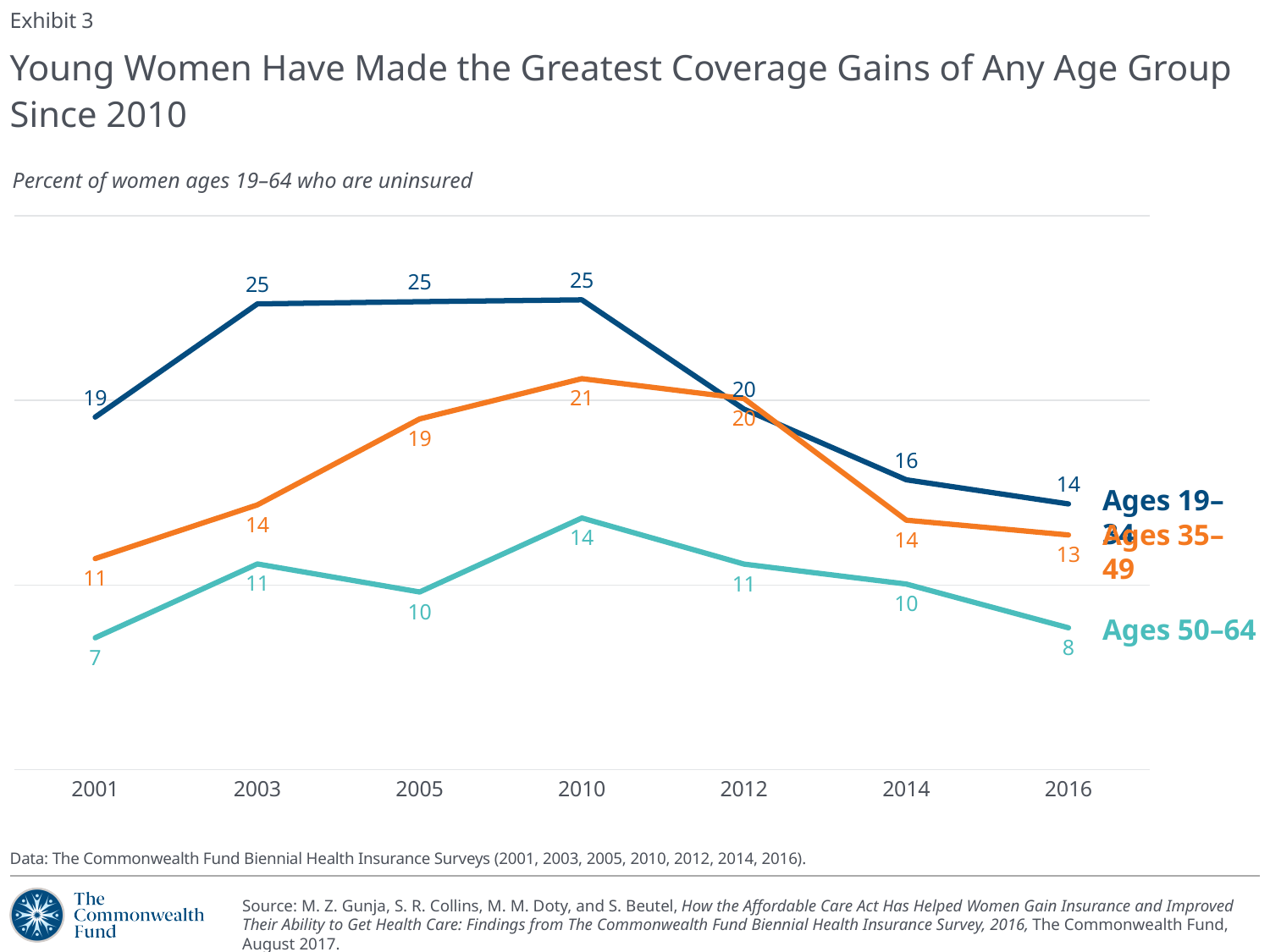
What is the difference between the Ages 19–34 value in 2010 and in 2016? 11 What is the value for Ages 35–49 in 2005? 19 In which year is the value for Ages 35–49 highest? 2010 In which year is the value for Ages 50–64 lowest? 2001 What is the value for Ages 50–64 in 2016? 8 Does the value for Ages 19–34 rise or fall from 2010 to 2016? Fall What is the value for Ages 19–34 in 2010? 25 What is the subtitle describing the measure plotted on the chart? Percent of women ages 19–64 who are uninsured Which series has the larger value in 2003, Ages 19–34 or Ages 50–64? Ages 19–34 How many years are plotted along the x axis? 7 What type of chart is shown on the slide? Line chart How many series does the chart show? 3